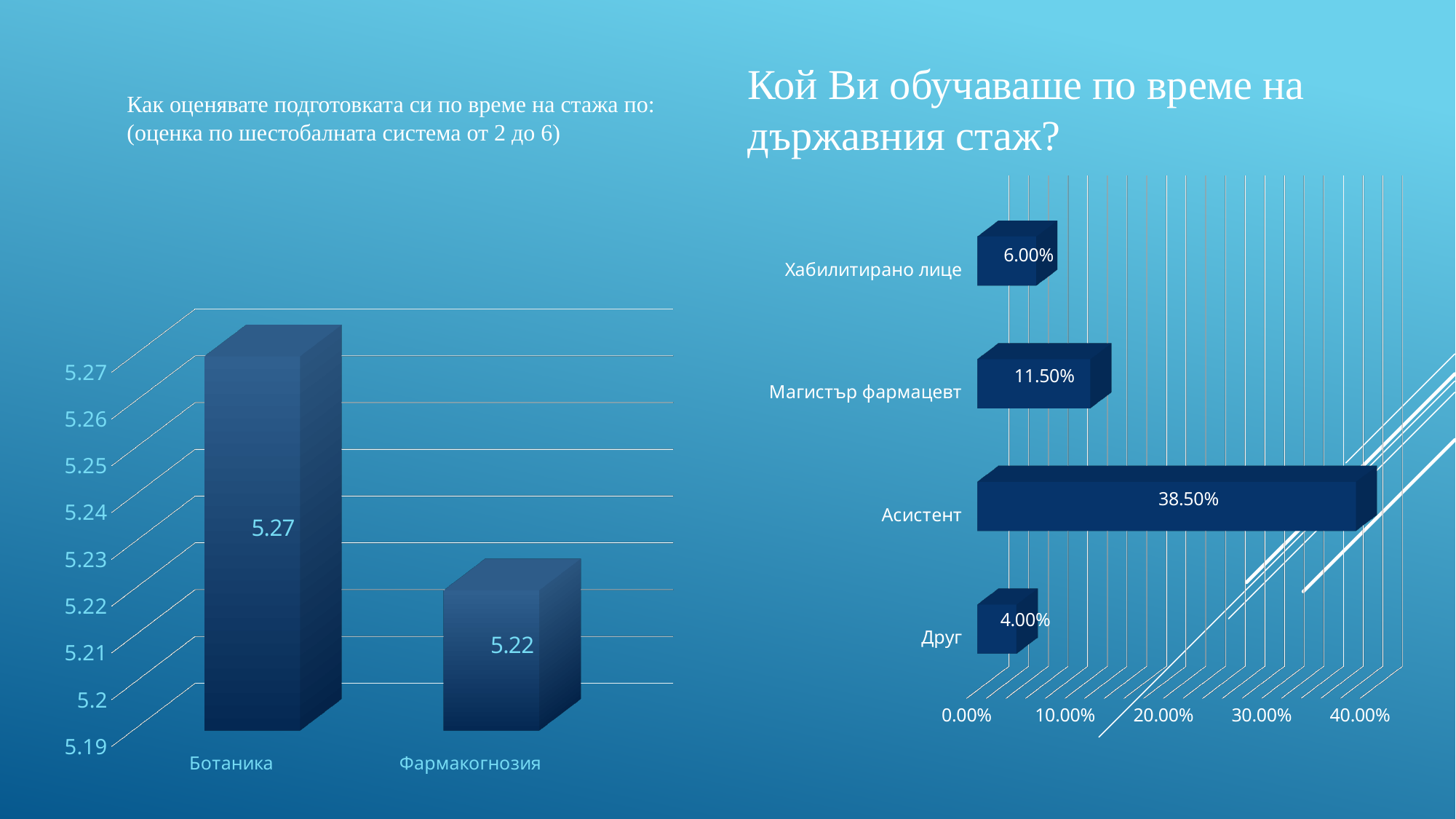
In the chart titled 'Кой Ви обучаваше по време на държавния стаж?', what is the value for Магистър фармацевт? 11.50% What kind of chart is the left chart? bar chart In the chart titled 'Кой Ви обучаваше по време на държавния стаж?', which category has the lowest value? Друг How many categories are shown in the chart titled 'Кой Ви обучаваше по време на държавния стаж?'? 4 In the chart titled 'Кой Ви обучаваше по време на държавния стаж?', which category has the highest value? Асистент In the chart titled 'Кой Ви обучаваше по време на държавния стаж?', what is the difference between the values for Хабилитирано лице and Друг? 2.00% In the left chart, what is the difference between the values for Ботаника and Фармакогнозия? 0.05 In the chart titled 'Кой Ви обучаваше по време на държавния стаж?', what is the value for Асистент? 38.50% In the left chart, what is the value for Ботаника? 5.27 In the left chart, what is the value for Фармакогнозия? 5.22 In the left chart, which category has the higher value? Ботаника How many categories are shown in the left chart? 2